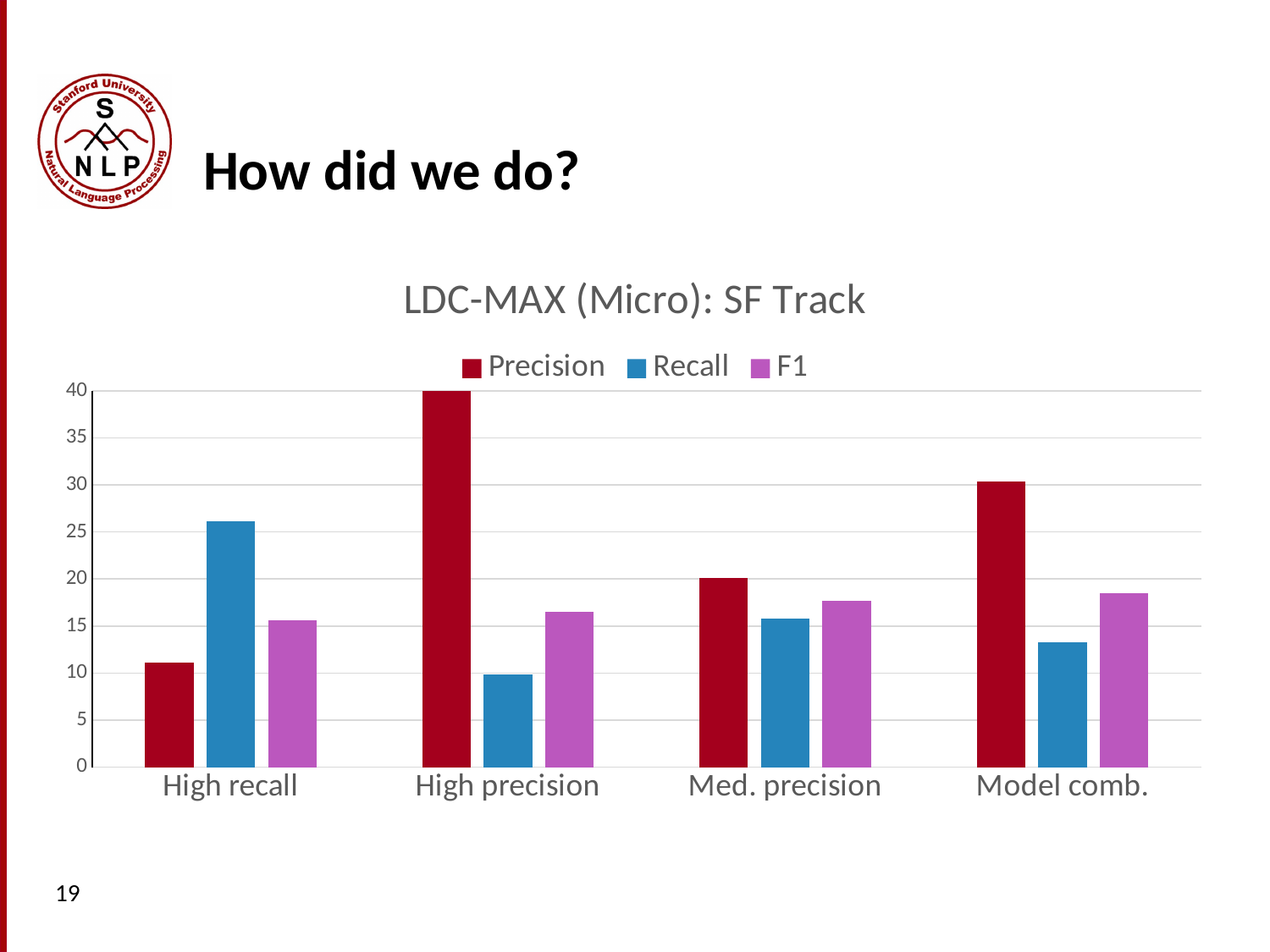
How many categories are shown on the x axis? 4 For High recall, which is larger, Precision or Recall? Recall Is the Precision value for High recall greater or less than 15? less Which category has the lowest Precision? High recall Is the Precision value for High precision greater or less than 35? greater How many series does the legend list? 3 Which category has the highest Precision? High precision Which category has the lowest Recall? High precision Is the Precision value for Model comb. greater or less than 25? greater Which category has the highest Recall? High recall What kind of chart is shown on the slide? bar chart What is the title of the chart? LDC-MAX (Micro): SF Track